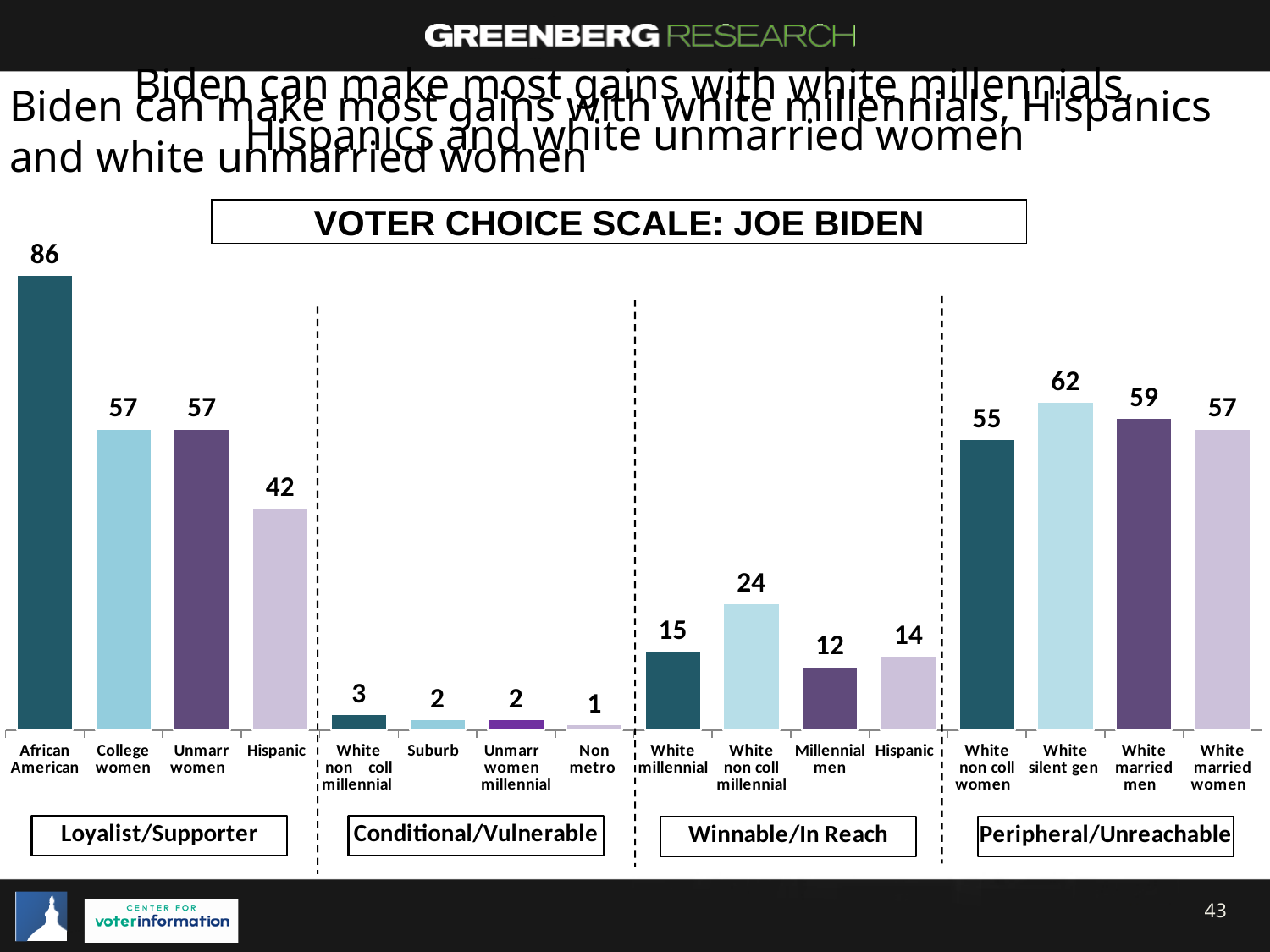
How many bars are plotted on the chart? 16 What is the value for White silent gen in the Peripheral/Unreachable group? 62 What is the value for Non metro in the Conditional/Vulnerable group? 1 Which category has the lowest value on the chart? Non metro What is the difference between the value for White silent gen and the value for White millennial in the Winnable/In Reach group? 47 What is the value for White non coll millennial in the Winnable/In Reach group? 24 What is the value for African American in the Loyalist/Supporter group? 86 Which is larger: the value for White married men or the value for White non coll women? White married men What kind of chart is shown under the title "VOTER CHOICE SCALE: JOE BIDEN"? Bar chart What is the difference between the value for African American and the value for Hispanic in the Loyalist/Supporter group? 44 Which category has the highest value on the chart? African American How many segment groups are labelled along the bottom of the chart? 4